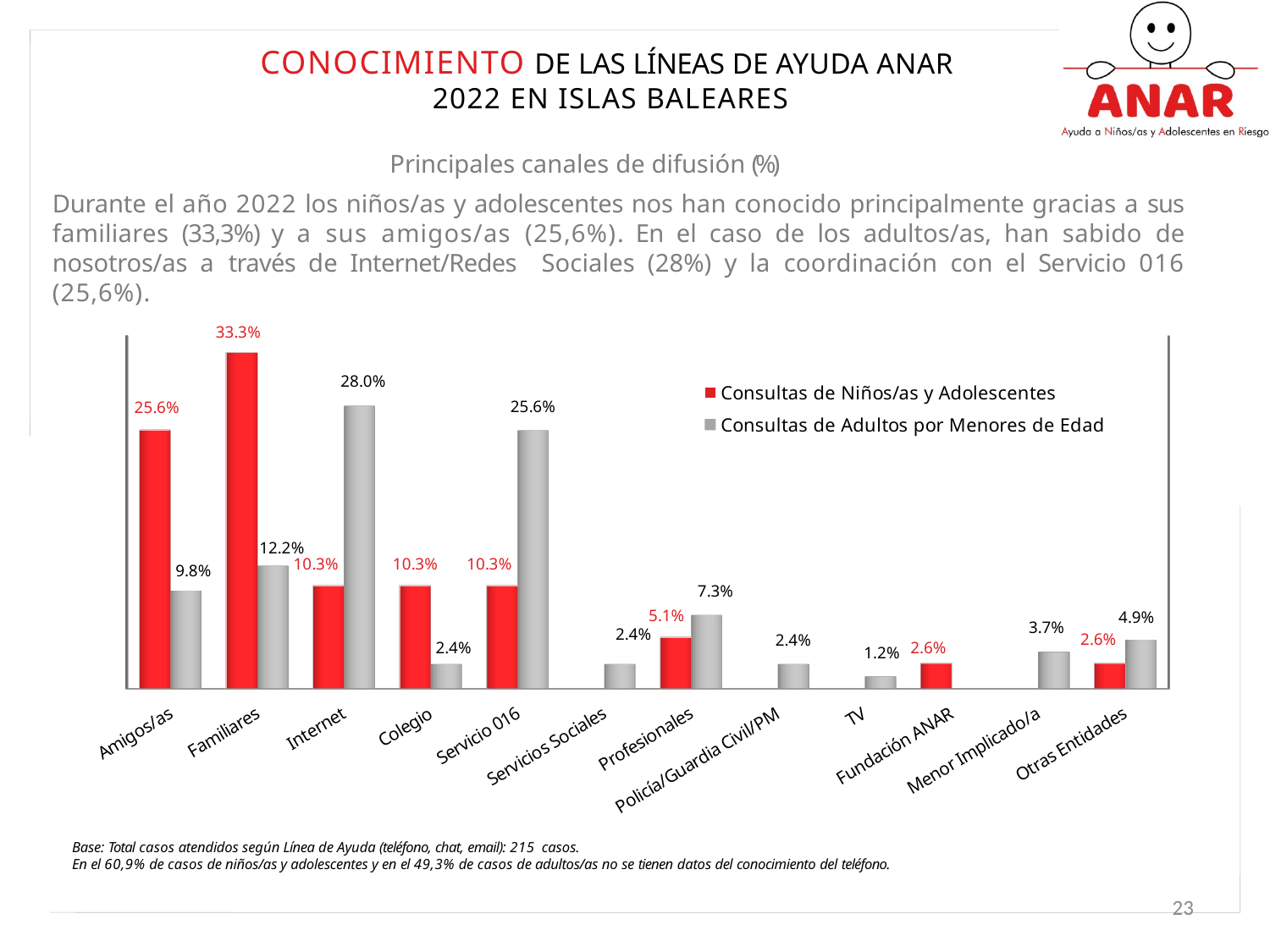
What is the difference between the Consultas de Niños/as y Adolescentes value and the Consultas de Adultos por Menores de Edad value for Familiares? 21.1% What is the value for Profesionales in the Consultas de Adultos por Menores de Edad series? 7.3% Which category has the highest value in the Consultas de Niños/as y Adolescentes series? Familiares How many categories are shown on the x axis of the chart? 12 For Servicio 016, which series has the larger value: Consultas de Niños/as y Adolescentes or Consultas de Adultos por Menores de Edad? Consultas de Adultos por Menores de Edad Which colour represents the Consultas de Niños/as y Adolescentes series in the chart? Red What is the value for Familiares in the Consultas de Niños/as y Adolescentes series? 33.3% What is the value for Amigos/as in the Consultas de Adultos por Menores de Edad series? 9.8% What kind of chart is shown on the slide? Bar chart What is the value for Internet in the Consultas de Adultos por Menores de Edad series? 28.0% How many series does the legend list? 2